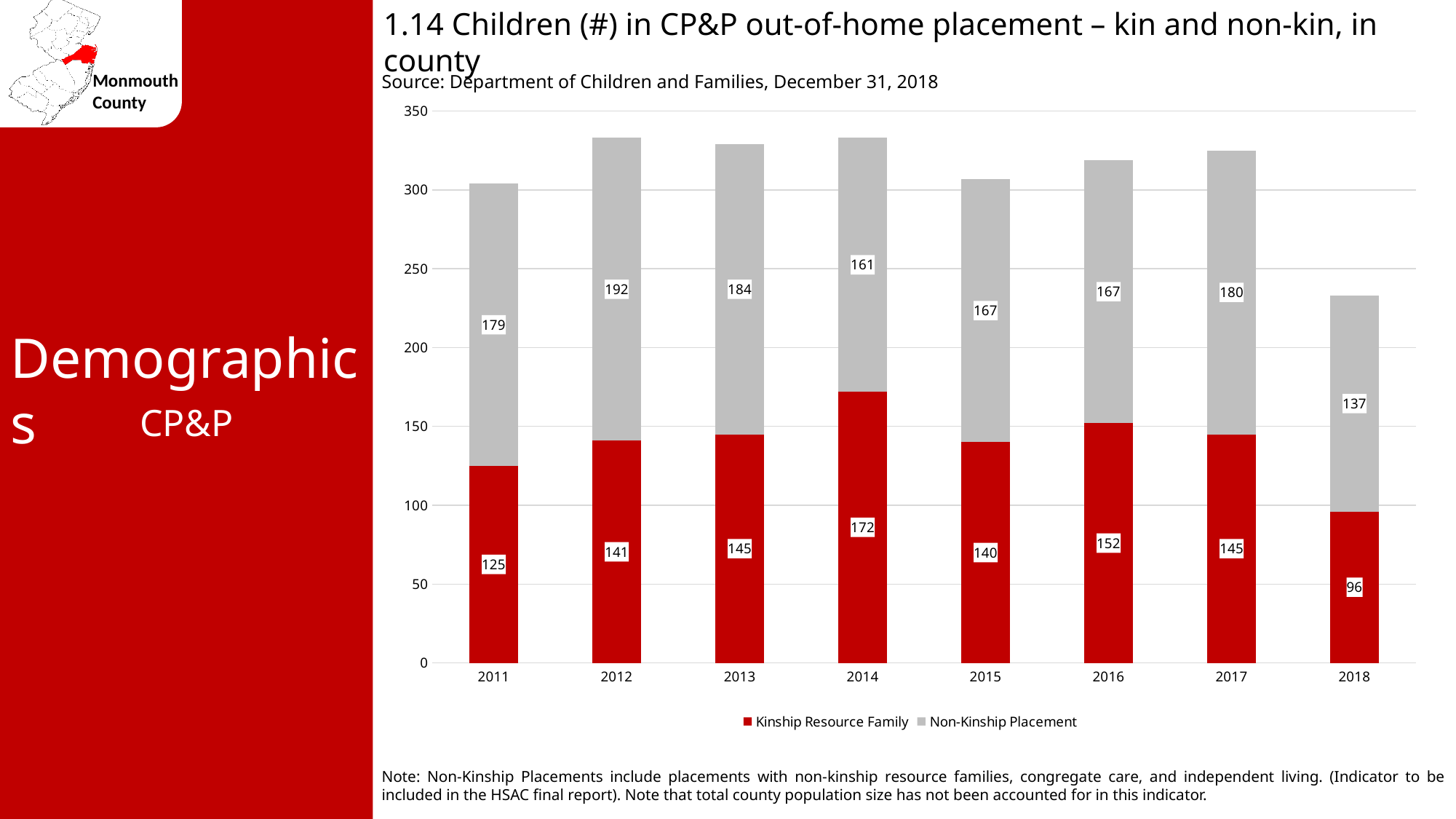
What is the difference between the Non-Kinship Placement value and the Kinship Resource Family value in 2011? 54 How many series does the legend list? 2 What kind of chart is shown on the slide? Stacked bar chart What is the total of the stacked bar for 2015? 307 How many years are shown on the x axis? 8 What is the Kinship Resource Family value for 2014? 172 What is the Non-Kinship Placement value for 2012? 192 Which year has the highest Kinship Resource Family value? 2014 Which is larger in 2017: Kinship Resource Family or Non-Kinship Placement? Non-Kinship Placement What is the Kinship Resource Family value for 2018? 96 What is the total of the stacked bar for 2018? 233 Which year has the lowest Non-Kinship Placement value? 2018